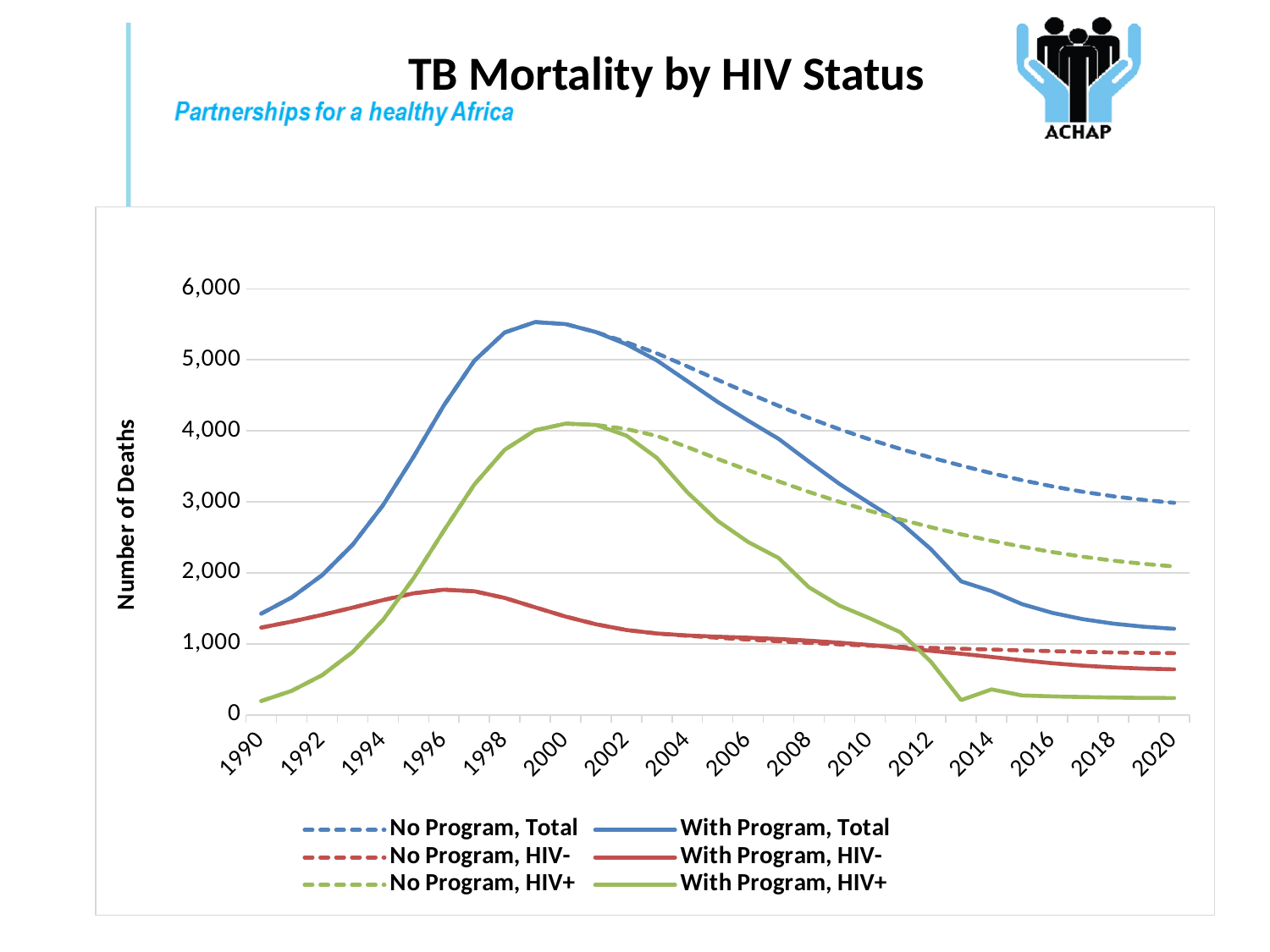
In 2020, which is larger: No Program, Total or With Program, Total? No Program, Total How many series does the legend list? 6 What is the title of the chart? TB Mortality by HIV Status Does the With Program, Total series rise or fall from 2000 to 2020? fall What is the label on the vertical axis? Number of Deaths Is the value for No Program, Total in 2020 greater or less than 2,000? greater Which series has the lowest value in 1990? No Program, HIV+ and With Program, HIV+ (equal) Is the value for With Program, Total in 2000 greater or less than 5,000? greater What kind of chart is shown on the slide? line chart Is the value for With Program, HIV+ in 2014 greater or less than 1,000? less Which series has the highest value in 2000? No Program, Total and With Program, Total (equal) How many year labels are shown along the x axis? 16